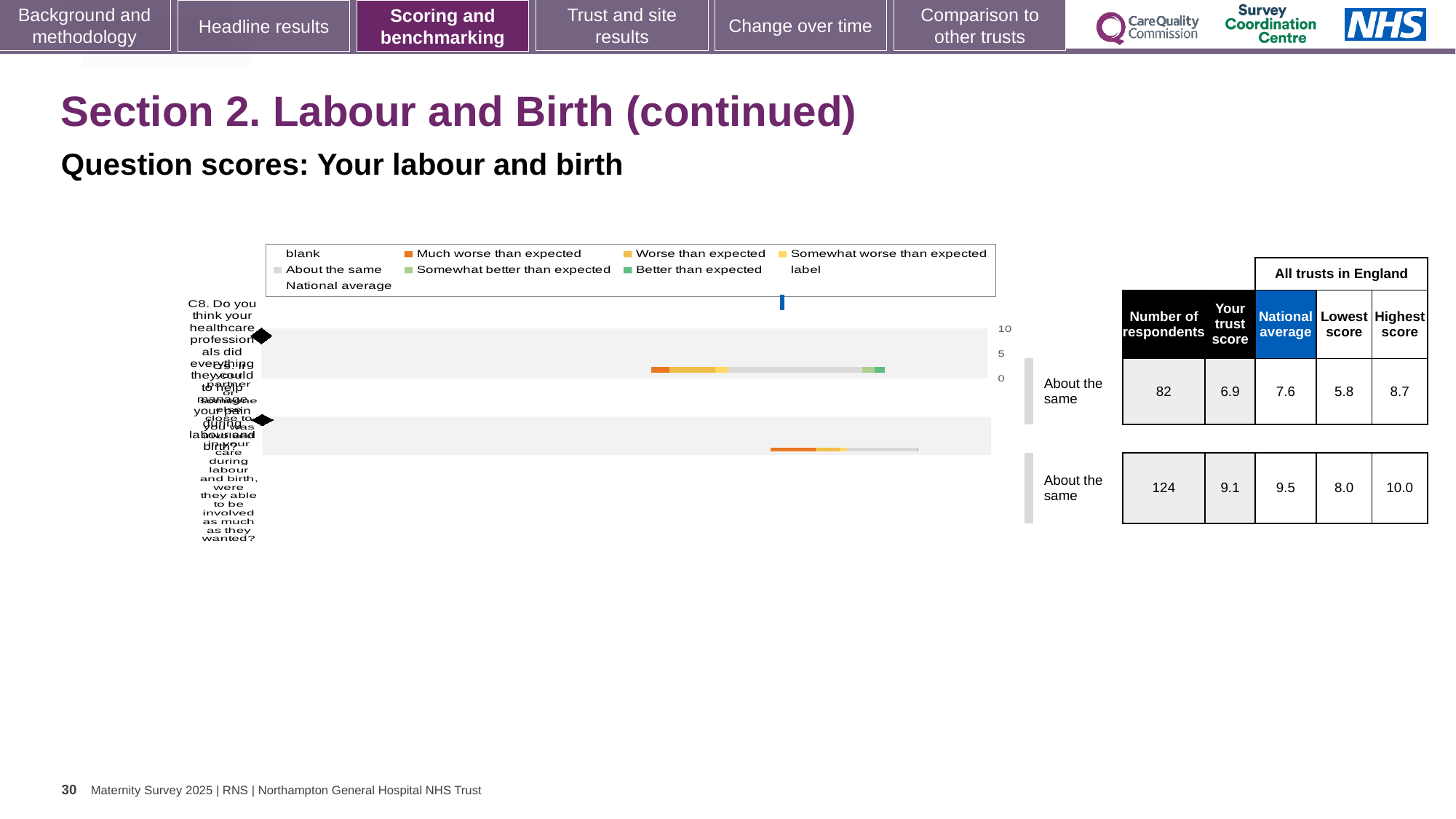
What benchmark category is shown for both question rows in the chart? About the same What is the difference in number of respondents between the second row (124) and the first row (82)? 42 How many question bars are plotted in the chart? 2 For the first row (question C8), what is the difference between the national average and the trust score? 0.7 In the table next to the chart, what is the trust score for the first row (question C8)? 6.9 In the table next to the chart, what is the highest score for the second row? 10.0 In the table next to the chart, what is the national average for the first row (question C8)? 7.6 What colour does the legend use for 'Much worse than expected'? orange For the first row (question C8), which is larger: the trust score or the national average? national average In the table next to the chart, what is the lowest score for the second row? 8.0 In the table next to the chart, how many respondents are shown for the first row (question C8)? 82 What kind of chart is shown on the slide? bar chart